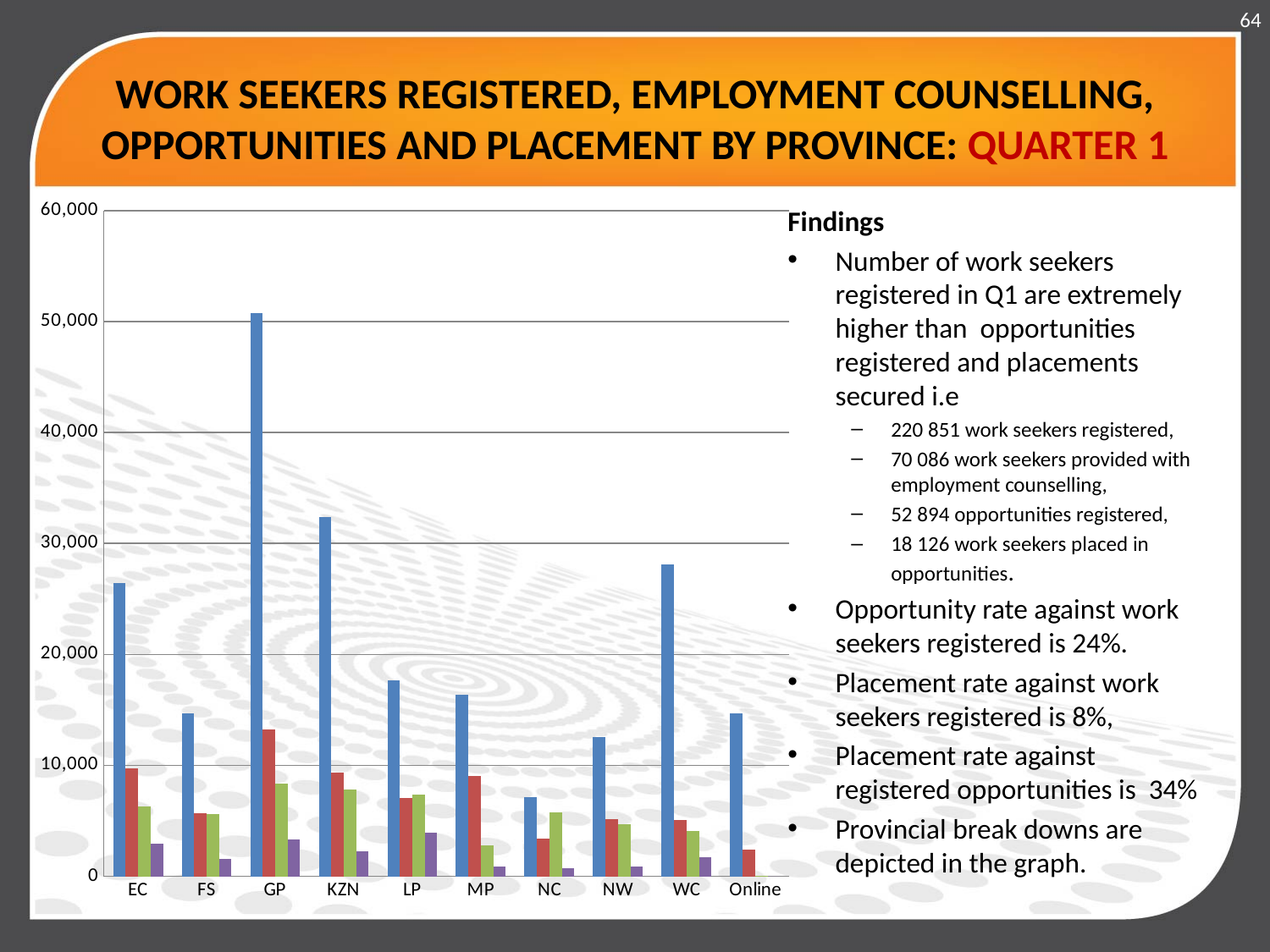
Is the blue bar for EC greater or less than 20,000? greater Is the blue bar for KZN greater or less than 30,000? greater How many categories are shown along the x axis of the chart? 10 Which has the larger blue bar, KZN or WC? KZN Is the blue bar for NC greater or less than 10,000? less What kind of chart is shown on the slide? bar chart Which category has the shortest blue bar in the chart? NC What is the highest value shown on the chart's vertical axis? 60,000 Which category has the tallest red bar in the chart? GP Which category has the tallest blue bar in the chart? GP